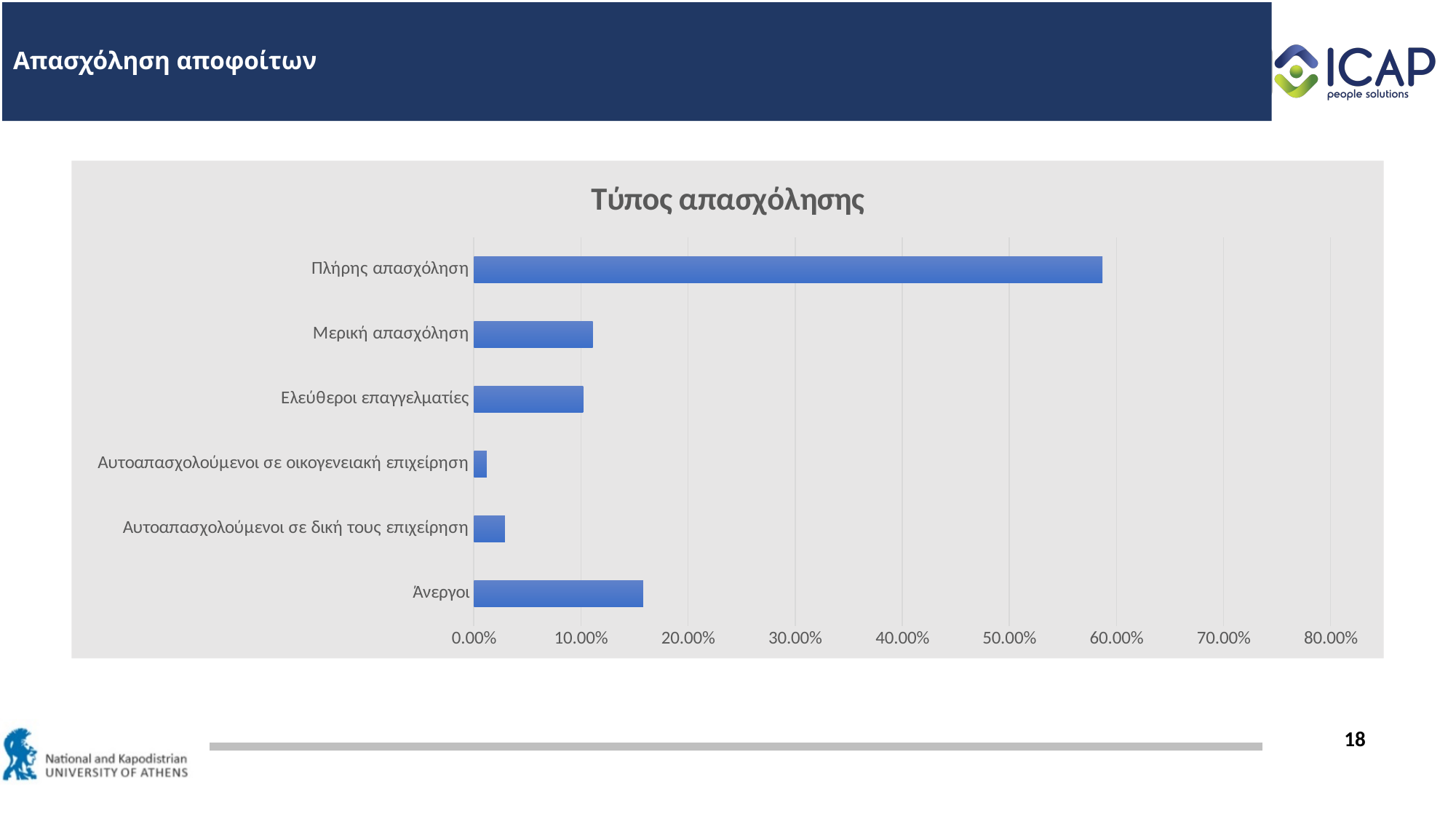
Is the value for Αυτοαπασχολούμενοι σε δική τους επιχείρηση greater or less than 10.00%? less Is the value for Πλήρης απασχόληση greater or less than 50.00%? greater What is the title of the chart? Τύπος απασχόλησης Which category has the highest value? Πλήρης απασχόληση Is the value for Πλήρης απασχόληση greater or less than 60.00%? less What type of chart is shown on the slide? Bar chart Which is larger, the value for Αυτοαπασχολούμενοι σε δική τους επιχείρηση or the value for Αυτοαπασχολούμενοι σε οικογενειακή επιχείρηση? Αυτοαπασχολούμενοι σε δική τους επιχείρηση How many categories are shown in the chart? 6 Which category has the lowest value? Αυτοαπασχολούμενοι σε οικογενειακή επιχείρηση Which is larger, the value for Άνεργοι or the value for Μερική απασχόληση? Άνεργοι